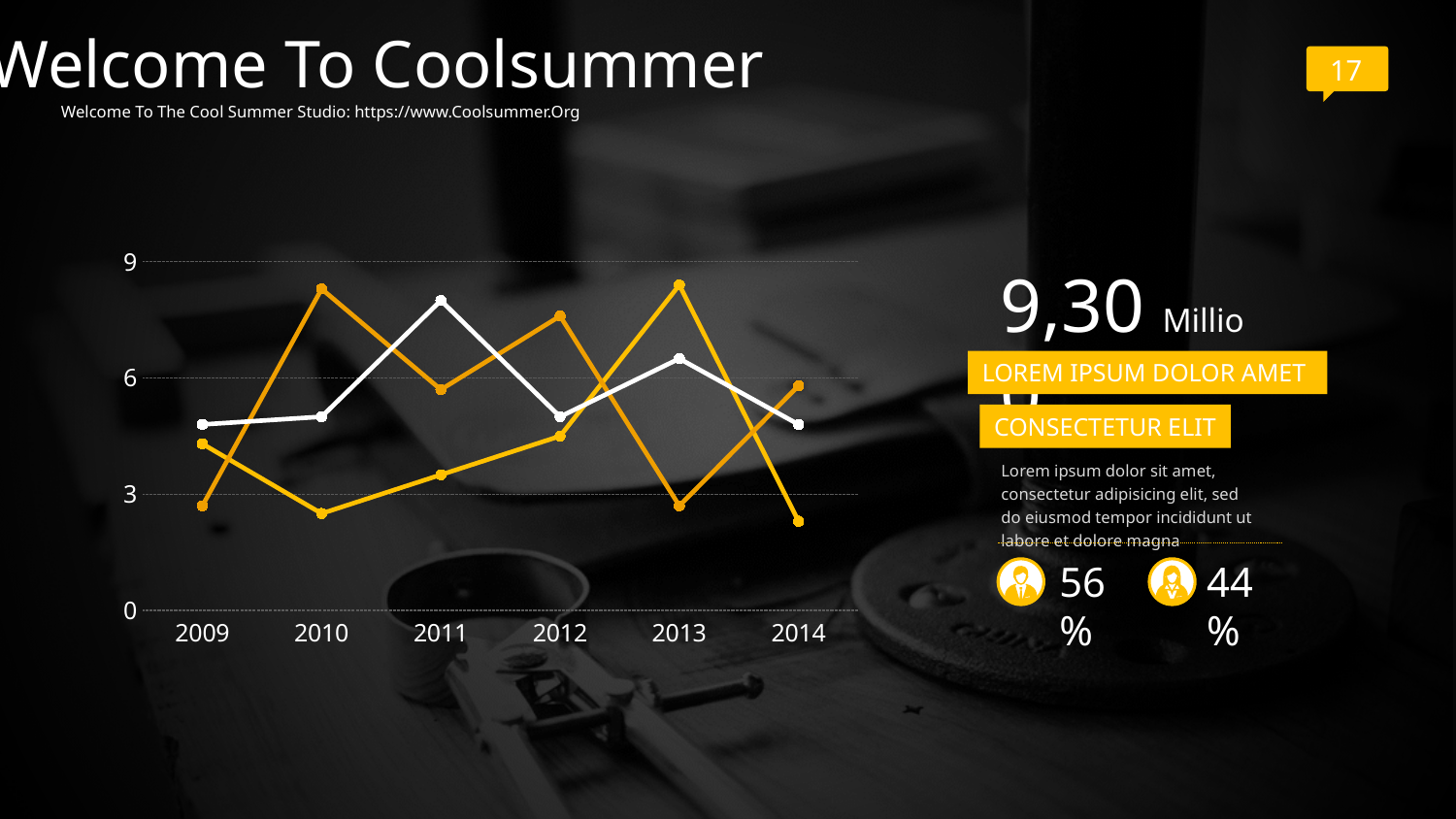
Which year has the larger value on the white line, 2009 or 2011? 2011 Is the value of the white line in 2012 greater or less than 6? less Is the value of the white line in 2009 greater or less than 6? less In which year does the white line reach its highest value? 2011 How many lines are plotted on the chart? 3 What is the first year shown on the x axis of the chart? 2009 Is the value of the white line in 2011 greater or less than 6? greater What kind of chart is shown on the slide? line chart What is the last year shown on the x axis of the chart? 2014 How many years are shown on the x axis of the chart? 6 Does the white line rise or fall between 2010 and 2011? rise